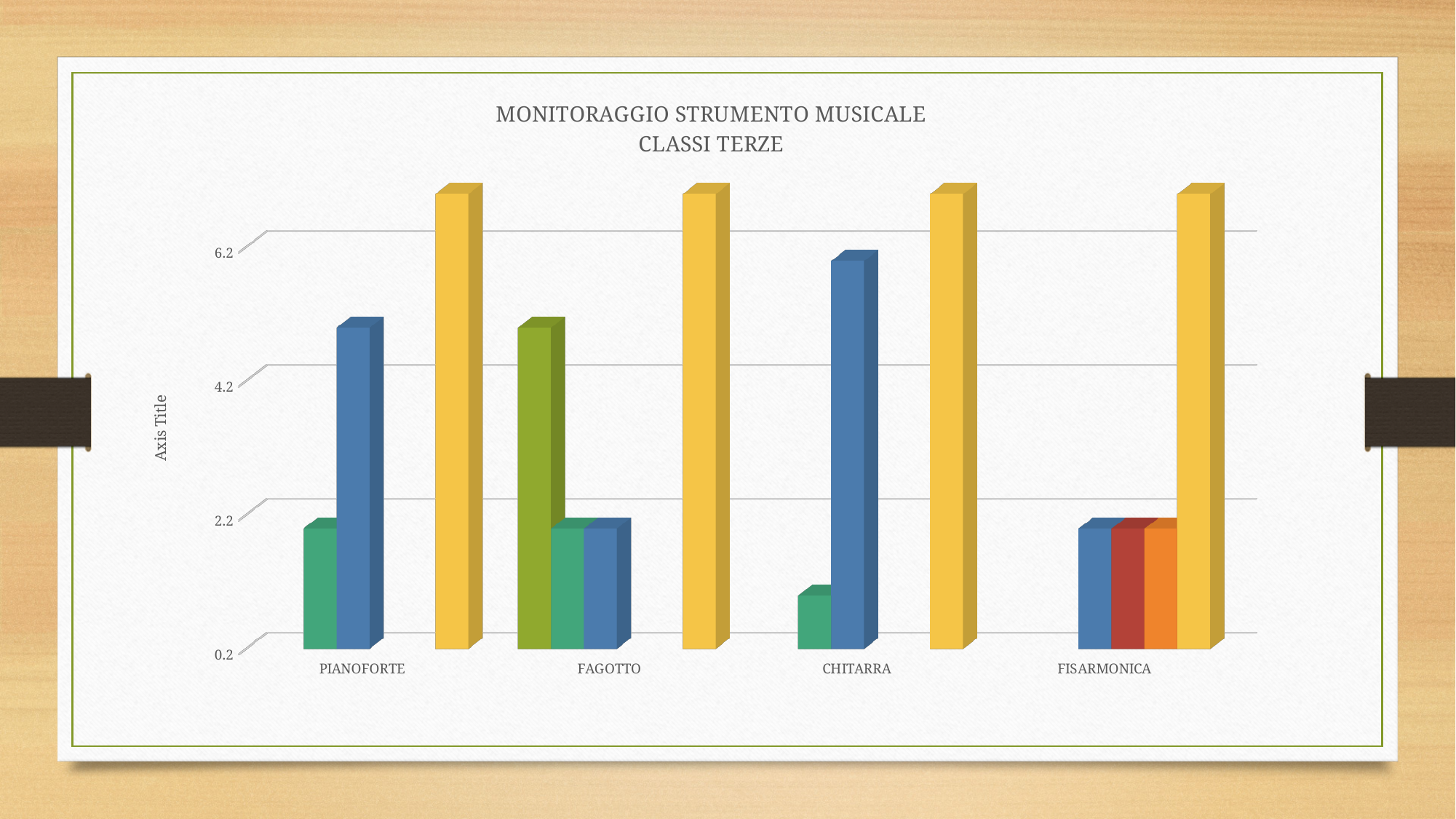
What is the title of the chart? MONITORAGGIO STRUMENTO MUSICALE CLASSI TERZE Is the value of the yellow bar for FISARMONICA greater or less than 4.2? greater What is the label of the vertical axis? Axis Title Which bar is the tallest in the CHITARRA category? the yellow bar Is the value of the yellow bar for PIANOFORTE greater or less than 6.2? greater Is the value of the teal bar for CHITARRA greater or less than 2.2? less Which is larger for CHITARRA, the blue bar or the teal bar? the blue bar How many categories are shown on the x axis of the chart? 4 What kind of chart is shown on the slide? bar chart